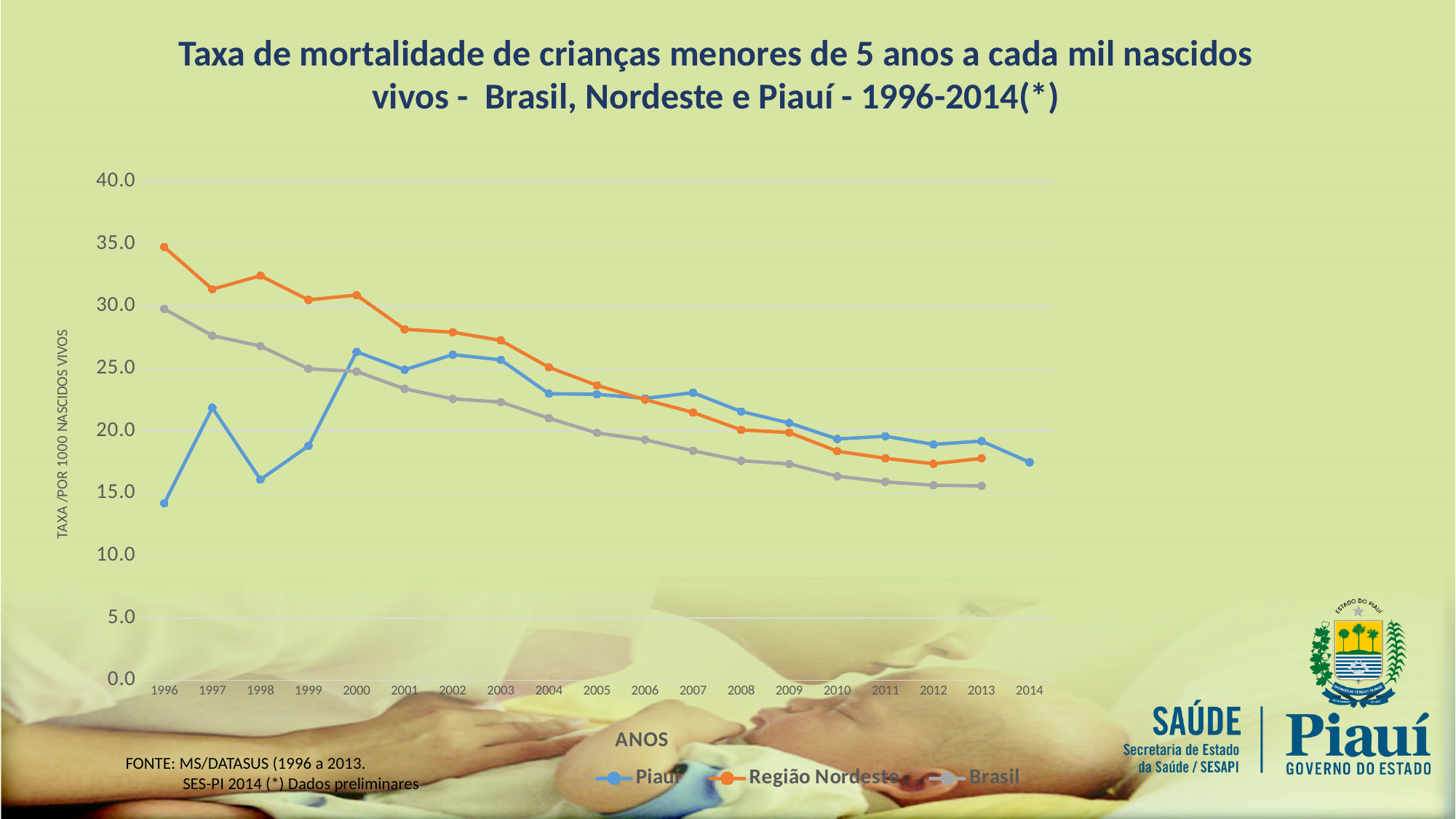
Is the value for Brasil in 2013 greater or less than 20.0? less How many series does the legend list? 3 Which series has the highest value in 1996? Região Nordeste How many years are shown on the x axis? 19 What kind of chart is shown on the slide? line chart In 1996, which is larger: the value for Região Nordeste or the value for Piauí? Região Nordeste What are the three series listed in the legend? Piauí, Região Nordeste, Brasil Is the value for Piauí in 1996 greater or less than 20.0? less Does the Brasil series rise or fall from 1996 to 2013? fall In 2000, which is larger: the value for Piauí or the value for Brasil? Piauí Is the value for Piauí in 2014 greater or less than 20.0? less